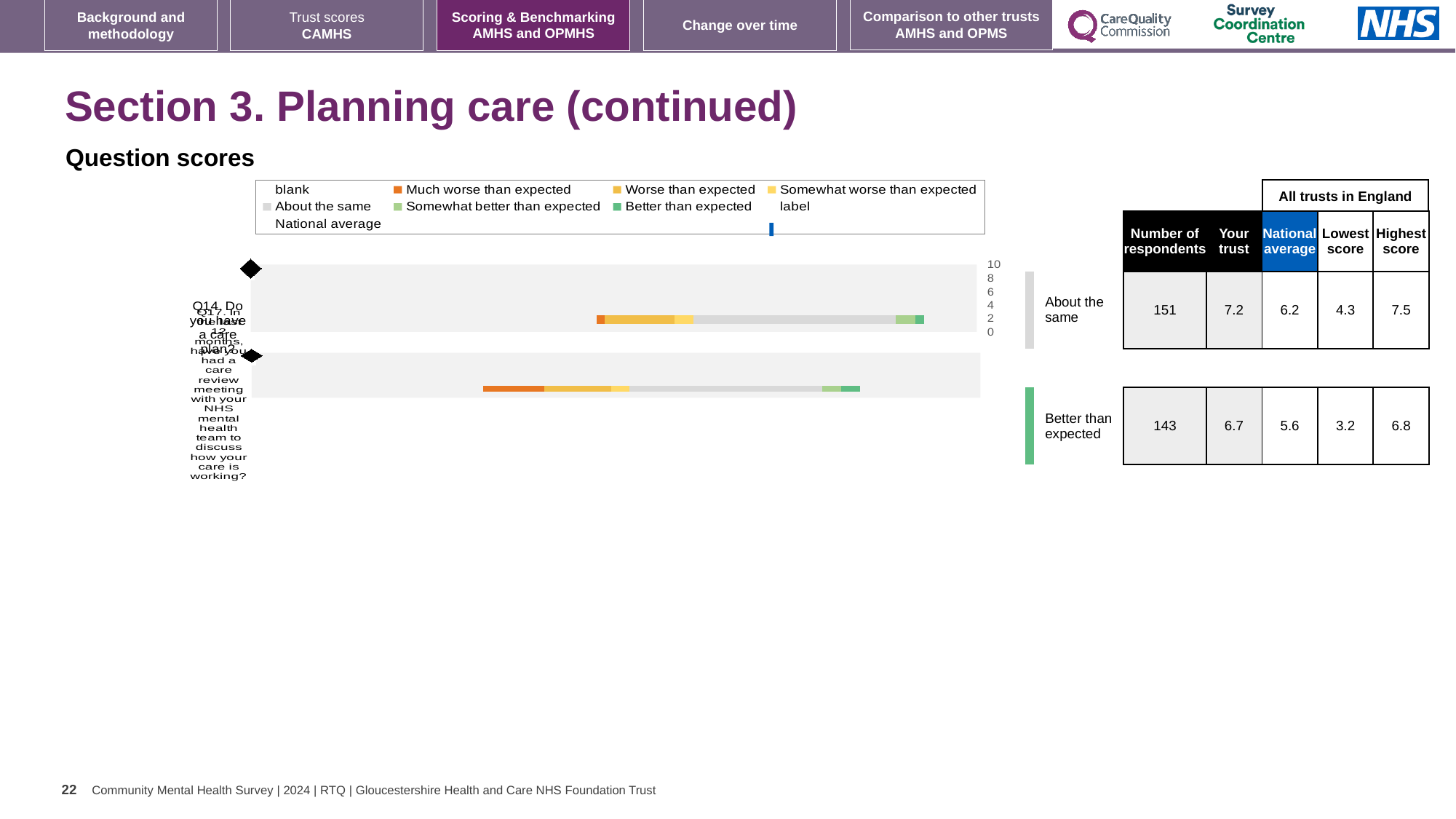
What is the number of respondents for the row labelled 'Better than expected'? 143 What is the highest score across all trusts in England for the row labelled 'Better than expected'? 6.8 In the table, what is the 'Your trust' score for the row labelled 'About the same'? 7.2 What is the national average for the row labelled 'About the same'? 6.2 What colour does the legend use for 'Much worse than expected'? orange What is the difference between the 'Your trust' score and the national average for the row labelled 'Better than expected'? 1.1 In the table, what is the 'Your trust' score for the row labelled 'Better than expected'? 6.7 What is the lowest score across all trusts in England for the row labelled 'About the same'? 4.3 What is the difference in number of respondents between the 'About the same' row and the 'Better than expected' row? 8 How many question bars are plotted in the chart? 2 What kind of chart is shown under 'Question scores'? bar chart Which row has the higher 'Your trust' score, 'About the same' or 'Better than expected'? About the same